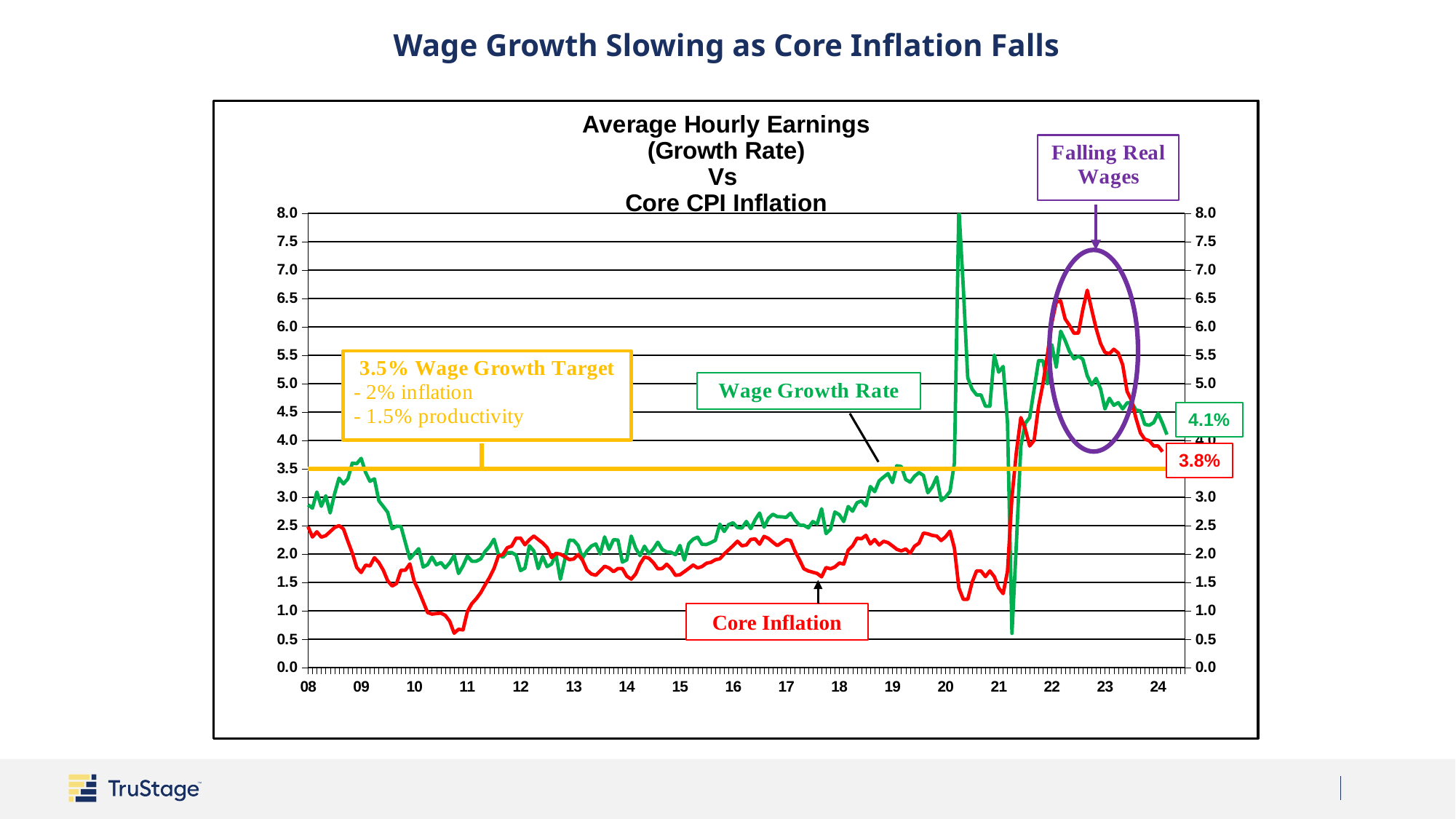
Is the peak of the Wage Growth Rate line in 2020 greater or less than 7.0? greater What is the difference between the latest labeled Wage Growth Rate (4.1%) and the latest labeled Core Inflation (3.8%)? 0.3% How many data series are plotted on the chart? 3 What is the most recent labeled value of the Core Inflation line? 3.8% What value is the horizontal yellow Wage Growth Target line set at? 3.5% What is the most recent labeled value of the Wage Growth Rate line? 4.1% Is the peak of the Core Inflation line in 2022 greater or less than 6.0? greater What does the purple oval on the chart highlight, according to its label? Falling Real Wages What kind of chart is shown on the slide? Line chart Is the lowest point of the Core Inflation line around 2010-2011 greater or less than 1.0? less From 2022 to 2024, does the Core Inflation line rise or fall? Fall At the end of the chart, which is higher: the Wage Growth Rate or Core Inflation? Wage Growth Rate